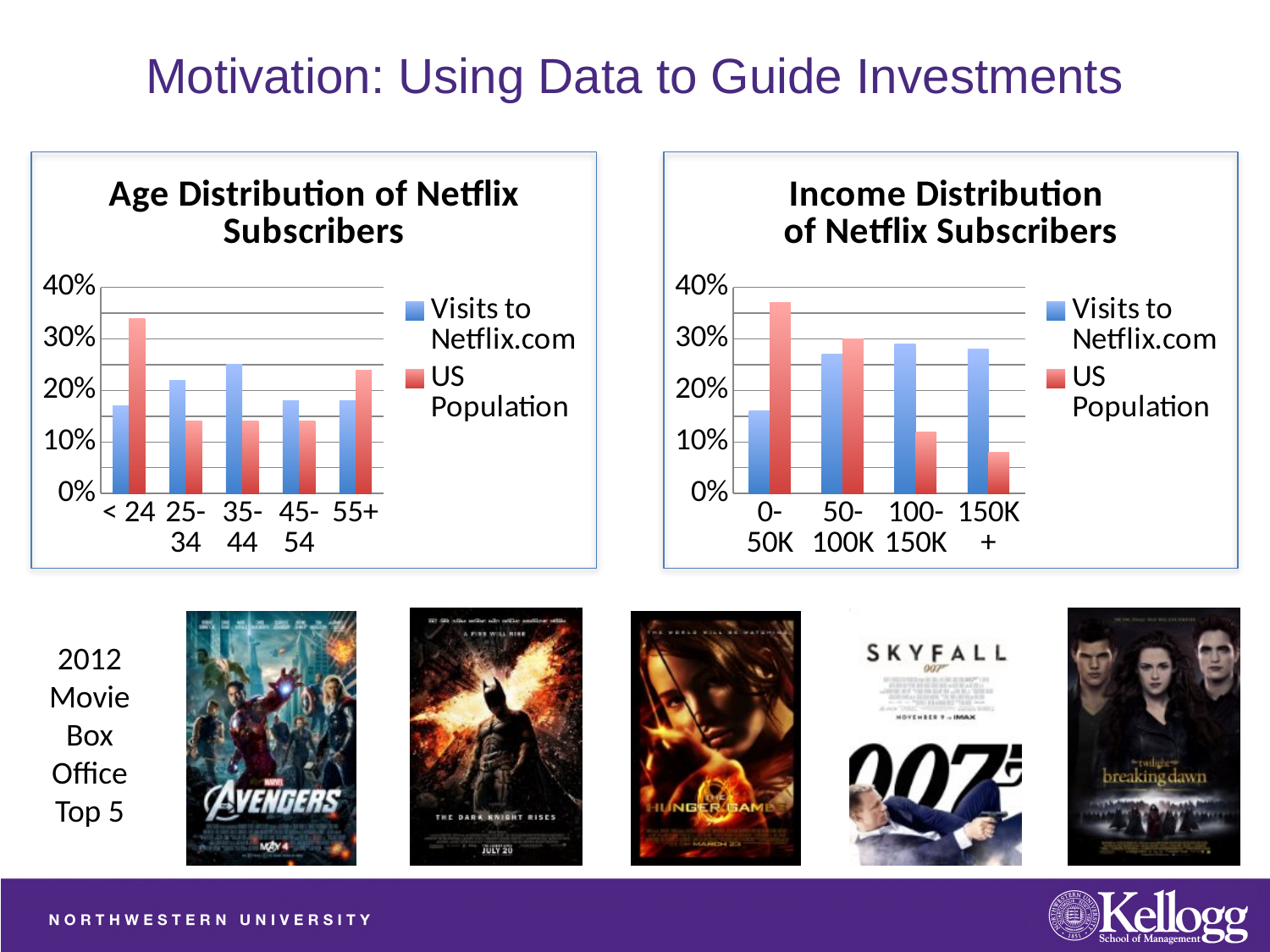
In the 'Age Distribution of Netflix Subscribers' chart, is the US Population value for < 24 greater or less than 30%? greater In the 'Age Distribution of Netflix Subscribers' chart, which age group has the highest US Population value? < 24 In the 'Income Distribution of Netflix Subscribers' chart, is the Visits to Netflix.com value for 0-50K greater or less than 20%? less In the 'Income Distribution of Netflix Subscribers' chart, which income group has the highest US Population value? 0-50K In the 'Age Distribution of Netflix Subscribers' chart, which age group has the highest Visits to Netflix.com value? 35-44 In the 'Age Distribution of Netflix Subscribers' chart, for the 55+ group, which is larger: Visits to Netflix.com or US Population? US Population What kind of chart is the 'Age Distribution of Netflix Subscribers' chart? bar chart In the 'Income Distribution of Netflix Subscribers' chart, which income group has the lowest US Population value? 150K+ In the 'Income Distribution of Netflix Subscribers' chart, what are the two legend entries? Visits to Netflix.com and US Population In the 'Age Distribution of Netflix Subscribers' chart, how many series does the legend list? 2 In the 'Income Distribution of Netflix Subscribers' chart, how many income categories are shown on the x axis? 4 In the 'Age Distribution of Netflix Subscribers' chart, how many age categories are shown on the x axis? 5